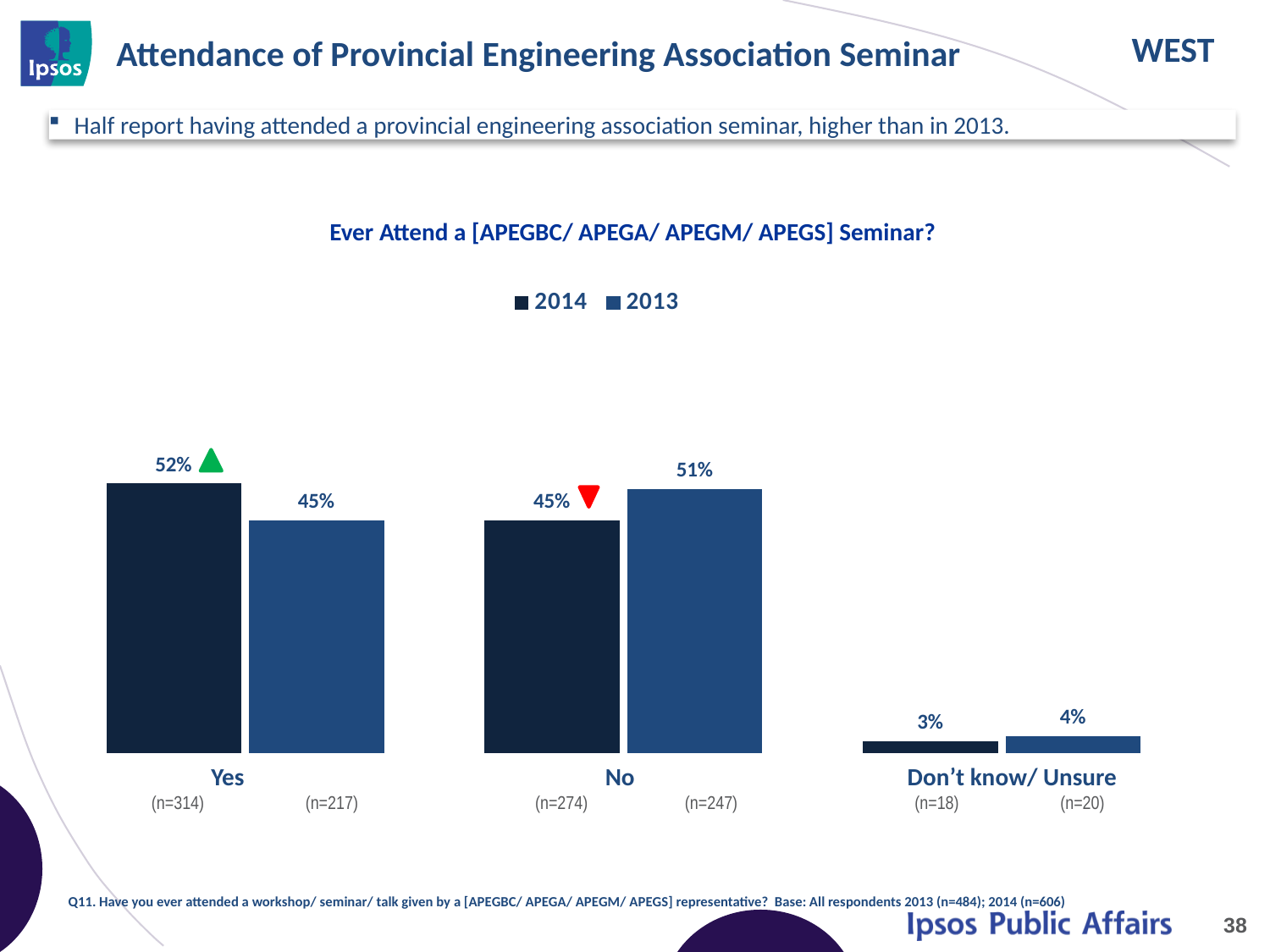
What percentage of respondents answered No in 2013? 51% What is the difference between the 2014 and 2013 values for Yes? 7 percentage points Which response category has the highest value in 2013? No What percentage of respondents answered Yes in 2014? 52% What is the 2013 value for Don't know/ Unsure? 4% How many series does the legend list? 2 How many response categories are shown on the chart? 3 Is the 2014 value for Yes larger or smaller than the 2013 value for Yes? larger What is the title of the chart? Ever Attend a [APEGBC/ APEGA/ APEGM/ APEGS] Seminar? Which response category has the lowest value in 2014? Don't know/ Unsure What is the difference between the 2013 and 2014 values for No? 6 percentage points What type of chart is shown on the slide? bar chart